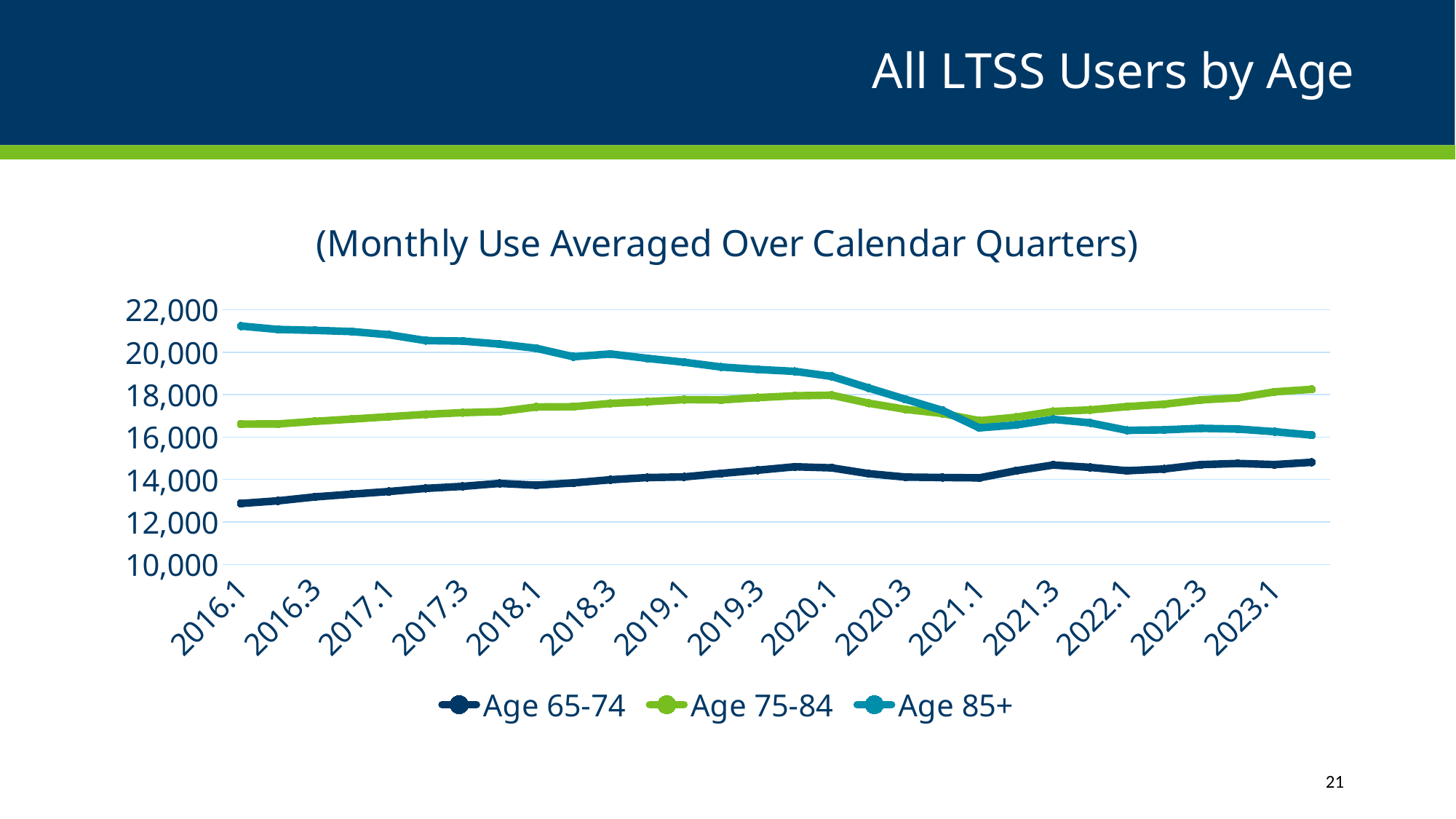
Is the value for Age 65-74 at 2023.1 greater or less than 14,000? greater Does the Age 65-74 series rise or fall from 2016.1 to 2023.1? rise Which series has the highest value at 2016.1? Age 85+ At 2023.1, which is larger: Age 75-84 or Age 85+? Age 75-84 How many series does the legend list? 3 Which series has the lowest value at 2016.1? Age 65-74 Does the Age 85+ series rise or fall from 2016.1 to 2023.1? fall What is the subtitle shown above the chart? (Monthly Use Averaged Over Calendar Quarters) Is the value for Age 65-74 at 2016.1 greater or less than 14,000? less Is the value for Age 85+ at 2023.1 greater or less than 18,000? less What kind of chart is shown on the slide? line chart